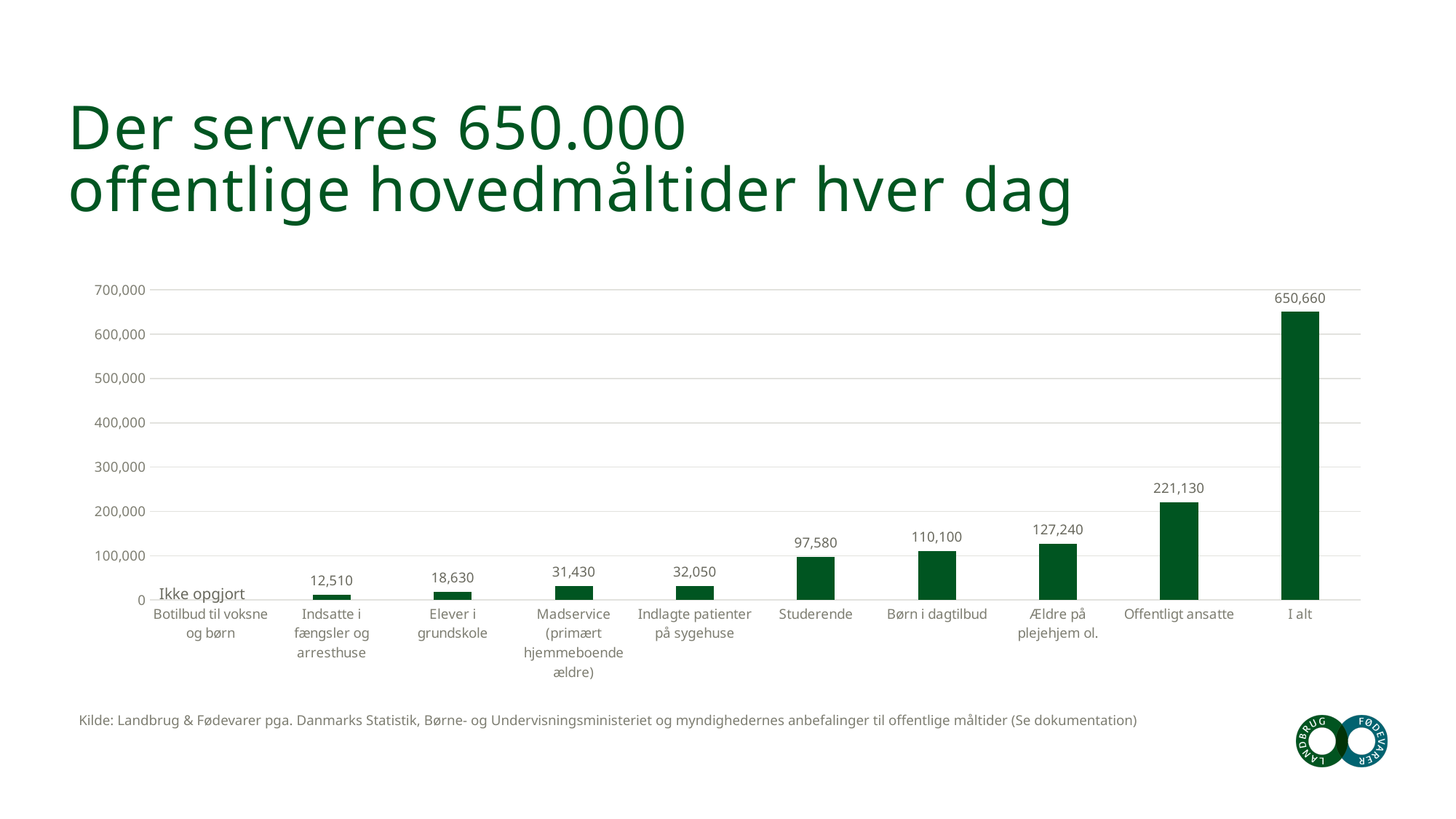
How many categories are shown on the x axis? 10 Which is larger, Børn i dagtilbud or Studerende? Børn i dagtilbud What value is shown for Ældre på plejehjem ol.? 127,240 What is the difference between Offentligt ansatte and Ældre på plejehjem ol.? 93,890 Is the value for I alt greater or less than 600,000? greater What kind of chart is shown on the slide? Bar chart Which category with a numeric value has the lowest value? Indsatte i fængsler og arresthuse What value is shown for Studerende? 97,580 What is shown for Botilbud til voksne og børn? Ikke opgjort What value is shown for Indsatte i fængsler og arresthuse? 12,510 What value is shown for Offentligt ansatte? 221,130 Which category has the highest value? I alt